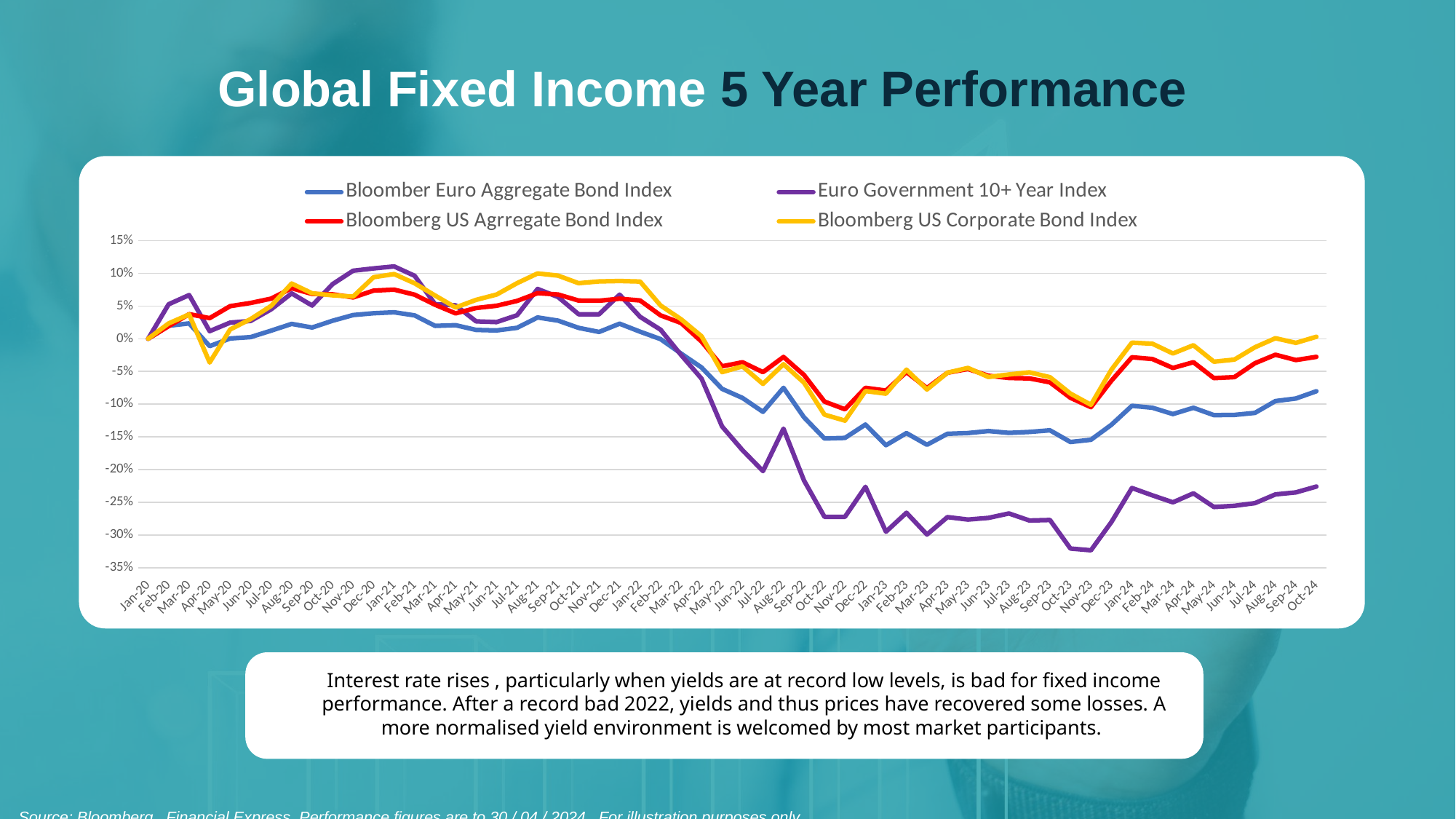
Does the Euro Government 10+ Year Index rise or fall between Jan-22 and Nov-23? Fall How many series does the legend list? 4 Is the value for the Bloomberg US Agrregate Bond Index at Oct-24 greater or less than -5%? greater Is the value for the Euro Government 10+ Year Index at Oct-22 greater or less than -25%? less Which series is shown in purple in the legend? Euro Government 10+ Year Index At Oct-24, which is larger: the Bloomberg US Corporate Bond Index or the Euro Government 10+ Year Index? Bloomberg US Corporate Bond Index Is the value for the Euro Government 10+ Year Index at Nov-23 greater or less than -30%? less What is the title of the slide containing the chart? Global Fixed Income 5 Year Performance What kind of chart is shown on the slide? Line chart How many monthly points are plotted along the x axis from Jan-20 to Oct-24? 58 Which series has the lowest value at Oct-24? Euro Government 10+ Year Index